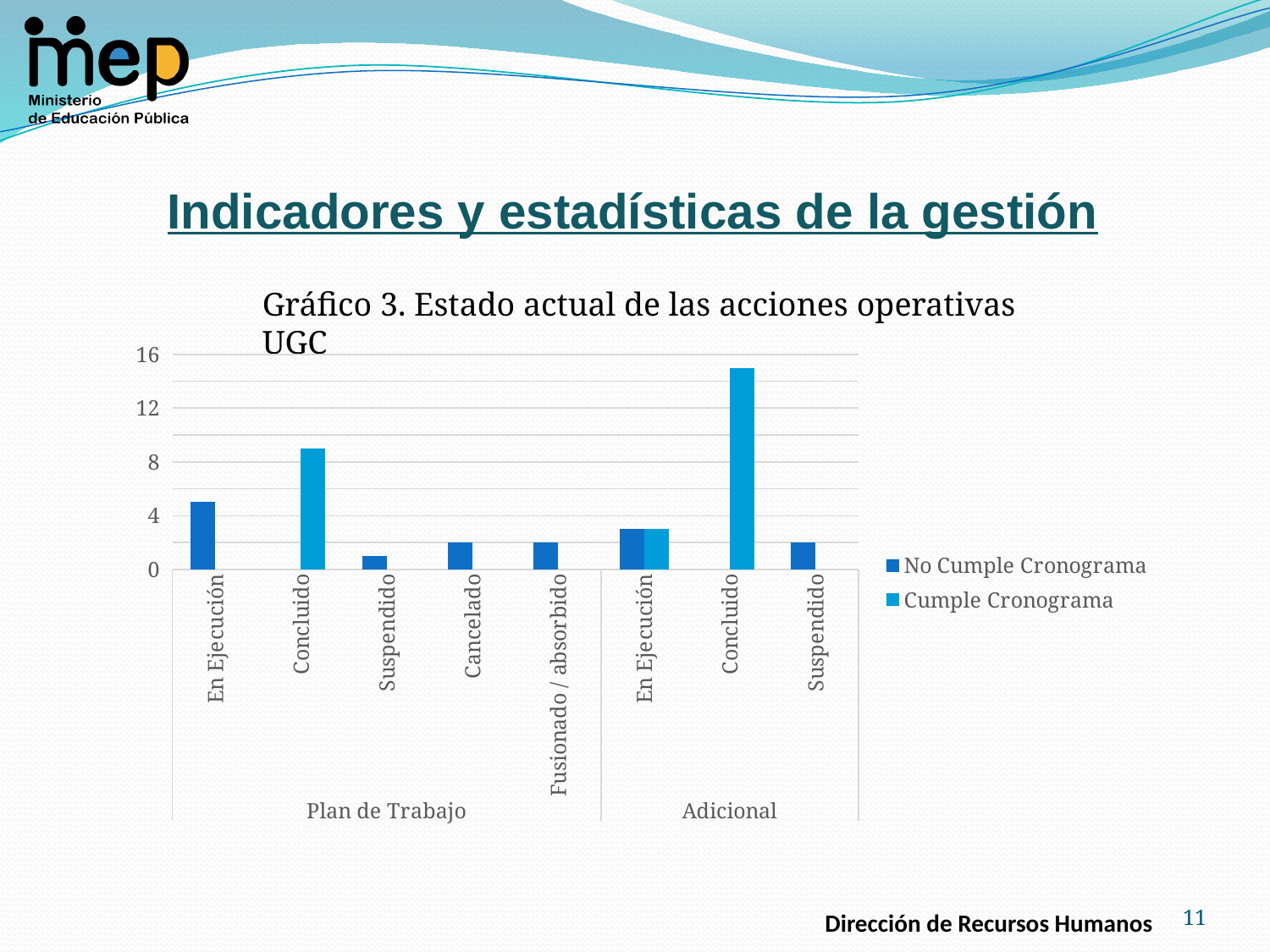
What is the title of the chart? Gráfico 3. Estado actual de las acciones operativas UGC What kind of chart is shown on the slide? Bar chart Which is larger: the Cumple Cronograma bar for Concluido under Plan de Trabajo or under Adicional? Adicional Is the No Cumple Cronograma value for En Ejecución under Plan de Trabajo greater or less than 8? less How many series does the legend list? 2 Is the Cumple Cronograma value for Concluido under Plan de Trabajo greater or less than 12? less How many categories are shown along the x axis? 8 What are the two series named in the legend? No Cumple Cronograma and Cumple Cronograma Which category has the tallest bar in the chart? Concluido (Adicional) Which category has the shortest bar in the chart? Suspendido (Plan de Trabajo) Is the Cumple Cronograma value for Concluido under Adicional greater or less than 12? greater Which is larger: the No Cumple Cronograma bar for En Ejecución under Plan de Trabajo or under Adicional? Plan de Trabajo